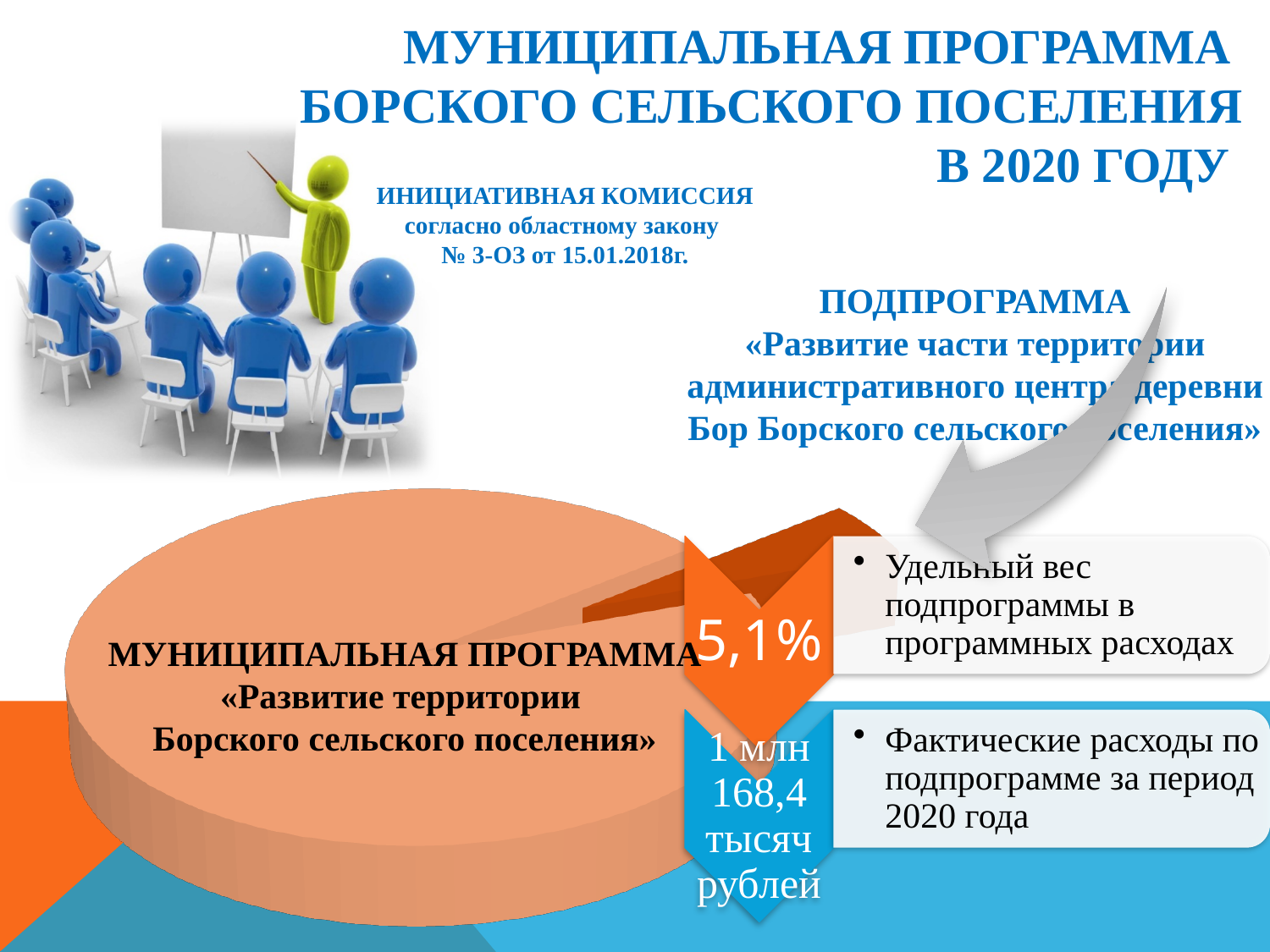
What is the name of the municipal program labelled on the large slice of the pie chart? «Развитие территории Борского сельского поселения» Which slice of the pie chart is larger: the municipal program «Развитие территории Борского сельского поселения» or the subprogram slice? МУНИЦИПАЛЬНАЯ ПРОГРАММА «Развитие территории Борского сельского поселения» What kind of chart is shown on the slide? pie chart What share of the pie chart does the subprogram «Развитие части территории административного центра деревни Бор Борского сельского поселения» represent? 5,1% Which slice of the pie chart is the smallest? the subprogram slice (5,1%) What does the 5,1% value on the pie chart represent? Удельный вес подпрограммы в программных расходах Is the share of the subprogram in program expenses greater or less than 10%? less What are the actual expenses for the subprogram for the 2020 period, as shown next to the pie chart? 1 млн 168,4 тысяч рублей How many slices does the pie chart have? 2